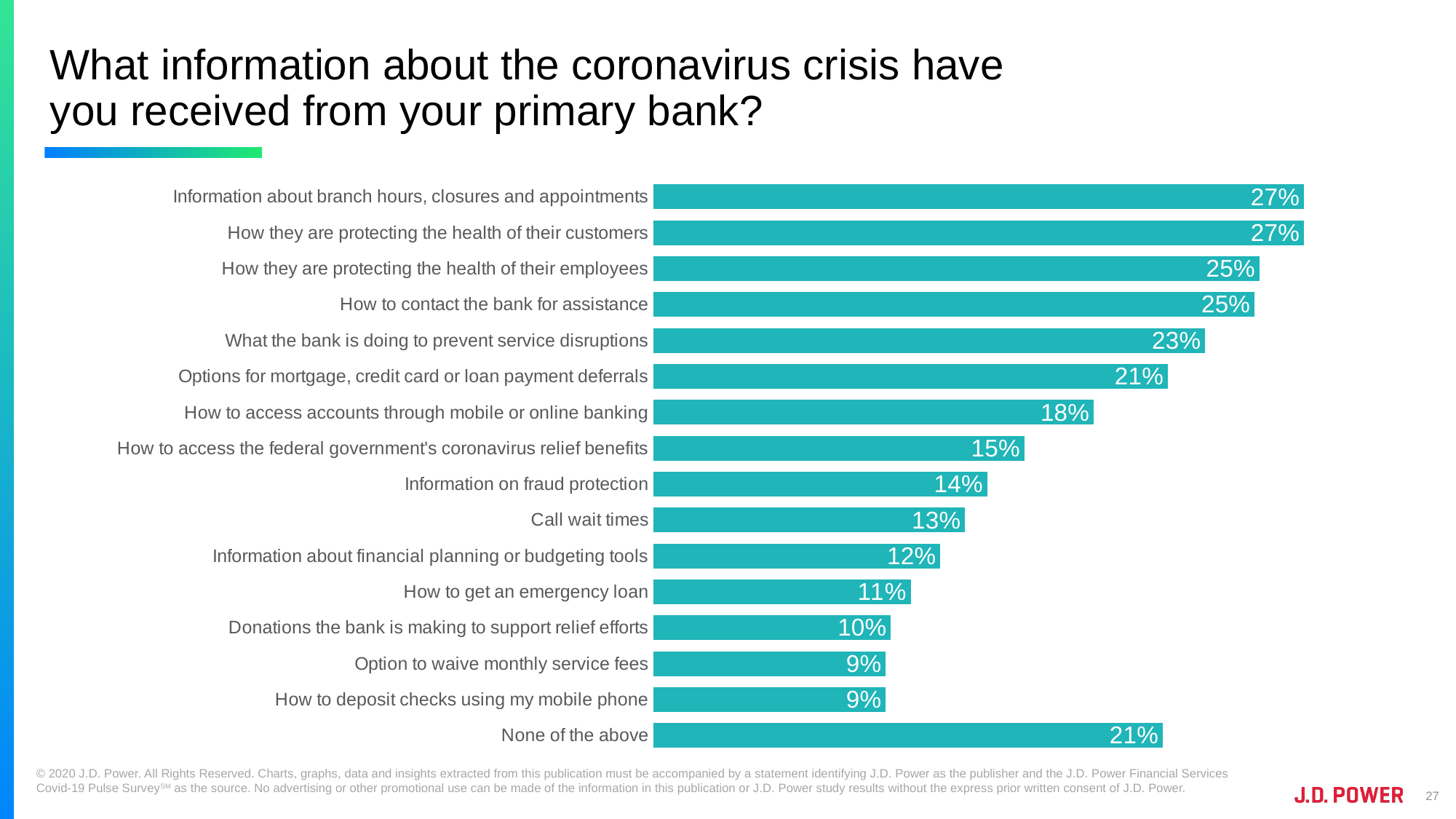
Which is larger: "How to access accounts through mobile or online banking" or "Information about financial planning or budgeting tools"? How to access accounts through mobile or online banking What kind of chart is shown on the slide? Bar chart What is the value for "Call wait times"? 13% Which category has the lowest value? Option to waive monthly service fees and How to deposit checks using my mobile phone (both 9%) What is the value for "None of the above"? 21% What is the value for "Information on fraud protection"? 14% What is the value for "How to contact the bank for assistance"? 25% What is the difference between "Information about branch hours, closures and appointments" and "How to get an emergency loan"? 16 percentage points What is the difference between "What the bank is doing to prevent service disruptions" and "Donations the bank is making to support relief efforts"? 13 percentage points What colour are the bars in the chart? Teal How many categories are shown in the chart? 16 What is the value for "Options for mortgage, credit card or loan payment deferrals"? 21%